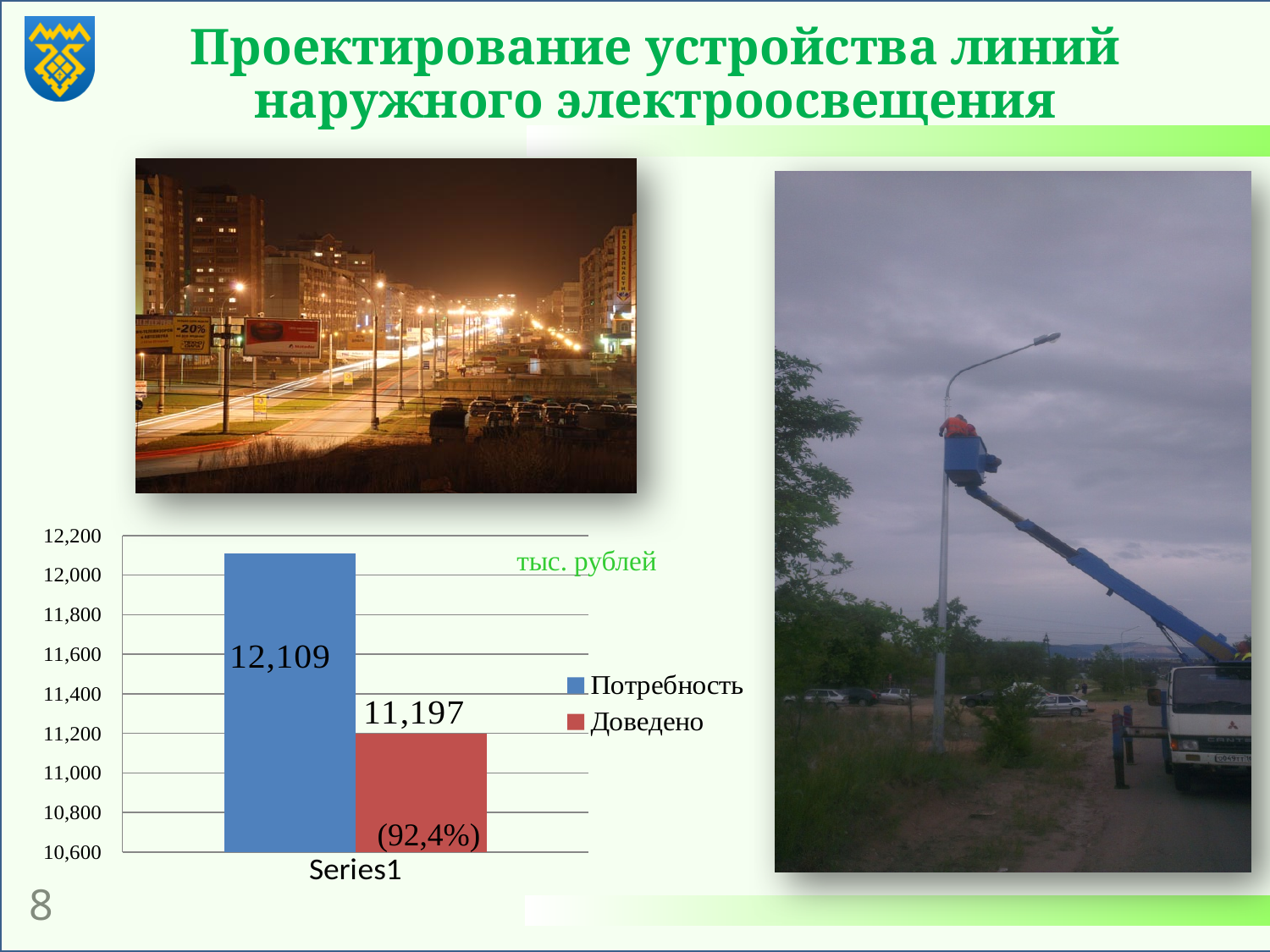
Is the value for Доведено greater or less than 11,400? less What is the difference between the Потребность and Доведено values? 912 Is the value for Потребность greater or less than 12,000? greater Which series has the higher value, Потребность or Доведено? Потребность What colour is the Потребность bar? blue How many series does the legend list? 2 What percentage is printed on the Доведено bar? (92,4%) What kind of chart is shown on the slide? bar chart What is the value for Доведено on the chart? 11,197 Which series has the lowest value on the chart? Доведено What is the value for Потребность on the chart? 12,109 What unit label is shown on the chart? тыс. рублей